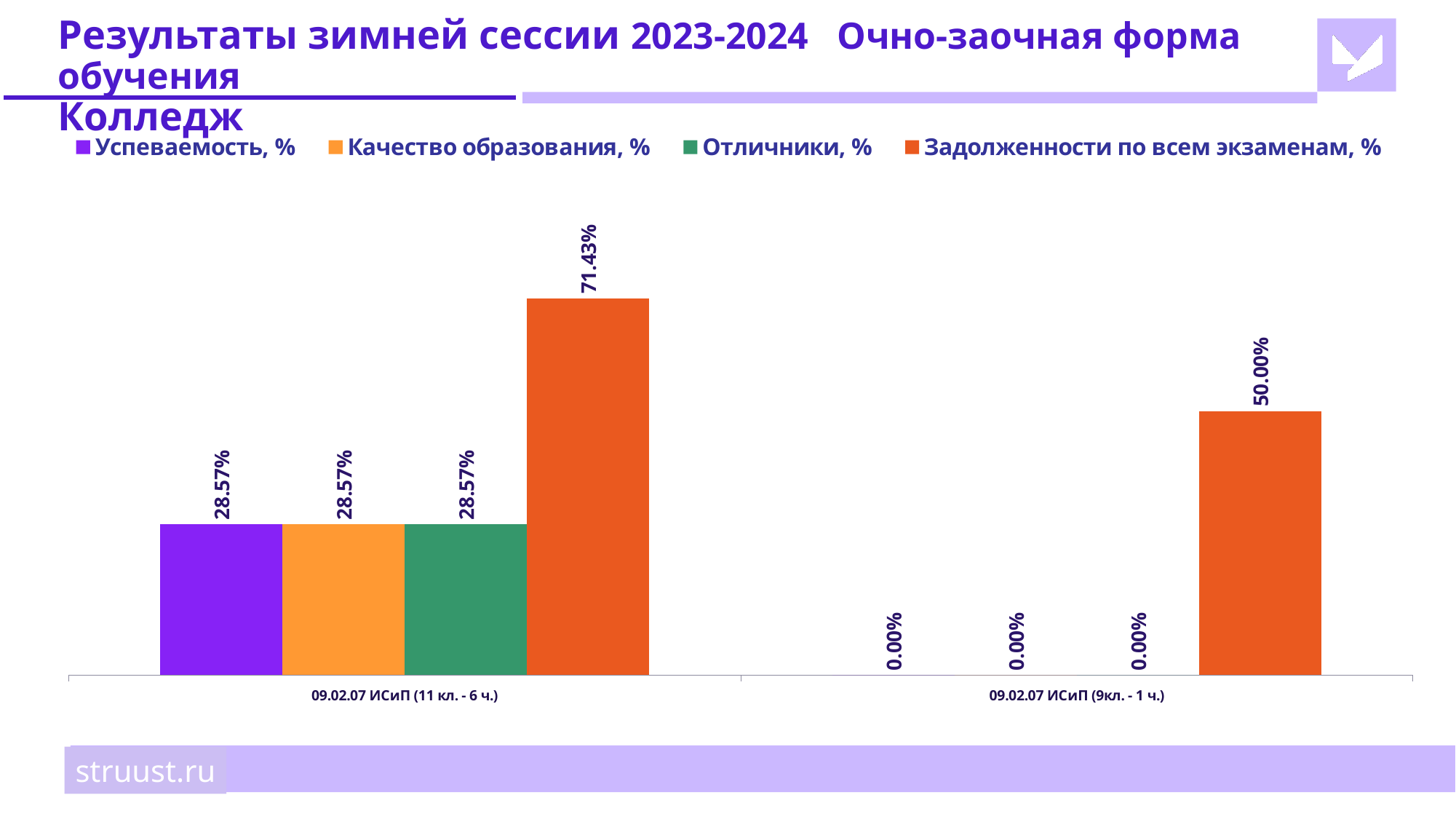
Which is larger for 09.02.07 ИСиП (9кл. - 1 ч.): Успеваемость, % or Задолженности по всем экзаменам, %? Задолженности по всем экзаменам, % What is the value of Отличники, % for 09.02.07 ИСиП (9кл. - 1 ч.)? 0.00% What is the difference between Задолженности по всем экзаменам, % for 09.02.07 ИСиП (11 кл. - 6 ч.) and for 09.02.07 ИСиП (9кл. - 1 ч.)? 21.43% What is the value of Задолженности по всем экзаменам, % for 09.02.07 ИСиП (9кл. - 1 ч.)? 50.00% Which category has the highest value for Задолженности по всем экзаменам, %? 09.02.07 ИСиП (11 кл. - 6 ч.) What is the value of Успеваемость, % for 09.02.07 ИСиП (11 кл. - 6 ч.)? 28.57% What is the value of Качество образования, % for 09.02.07 ИСиП (11 кл. - 6 ч.)? 28.57% What is the value of Задолженности по всем экзаменам, % for 09.02.07 ИСиП (11 кл. - 6 ч.)? 71.43% How many series does the legend list? 4 What kind of chart is shown on the slide? Bar chart How many categories are shown on the x axis? 2 What is the difference between Задолженности по всем экзаменам, % and Успеваемость, % for 09.02.07 ИСиП (11 кл. - 6 ч.)? 42.86%